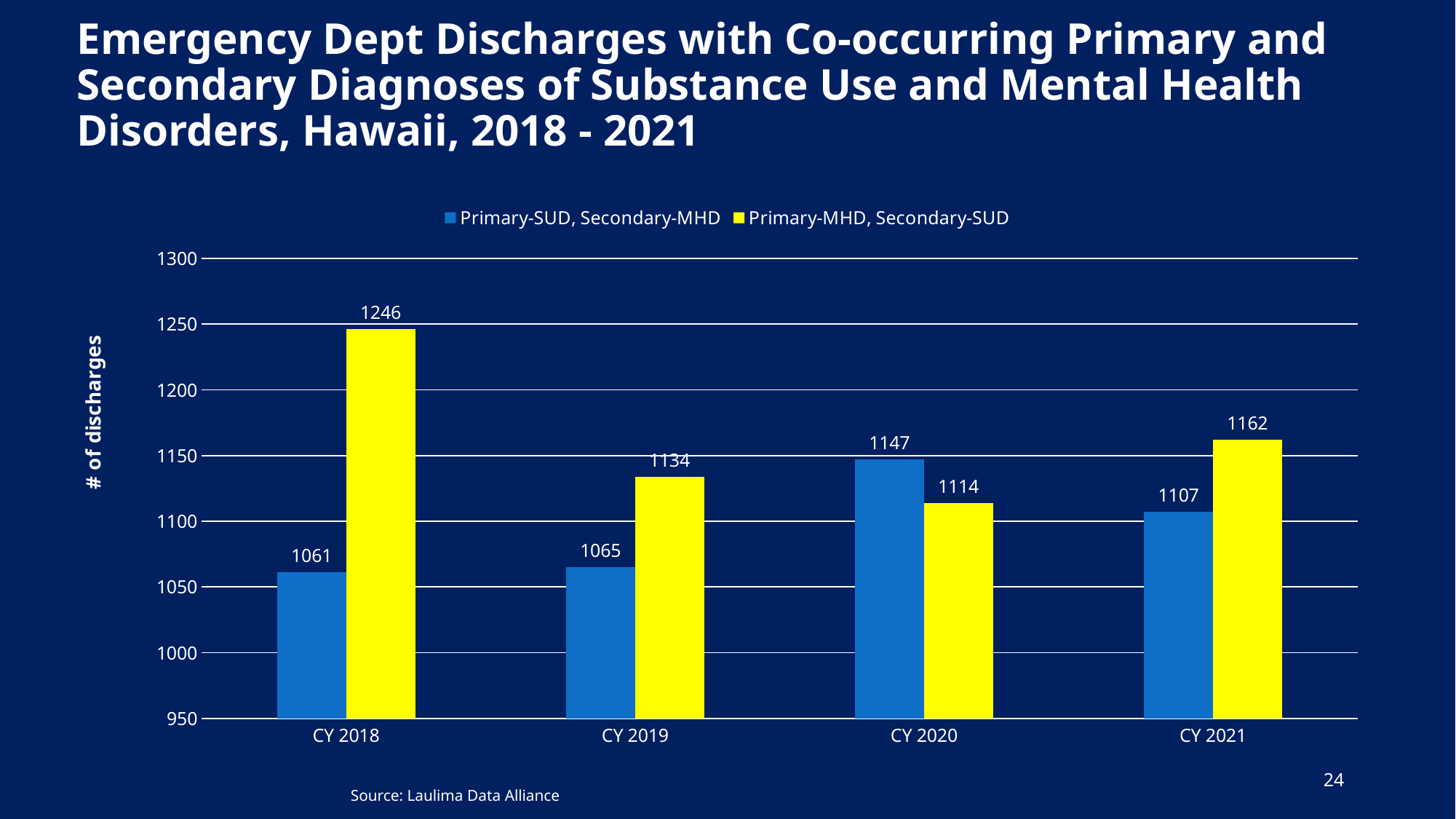
What is the value for Primary-MHD, Secondary-SUD in CY 2021? 1162 What kind of chart is shown on the slide? bar chart How many series does the legend list? 2 In CY 2020, which series has the larger value: Primary-SUD, Secondary-MHD or Primary-MHD, Secondary-SUD? Primary-SUD, Secondary-MHD Is the value for Primary-MHD, Secondary-SUD in CY 2019 greater or less than 1100? greater What is the label of the y axis? # of discharges What is the value for Primary-SUD, Secondary-MHD in CY 2018? 1061 What is the value for Primary-MHD, Secondary-SUD in CY 2020? 1114 In which year is the Primary-SUD, Secondary-MHD value lowest? CY 2018 What is the difference between the Primary-MHD, Secondary-SUD and Primary-SUD, Secondary-MHD values in CY 2018? 185 In which year is the Primary-MHD, Secondary-SUD value highest? CY 2018 How many years are shown on the x axis? 4